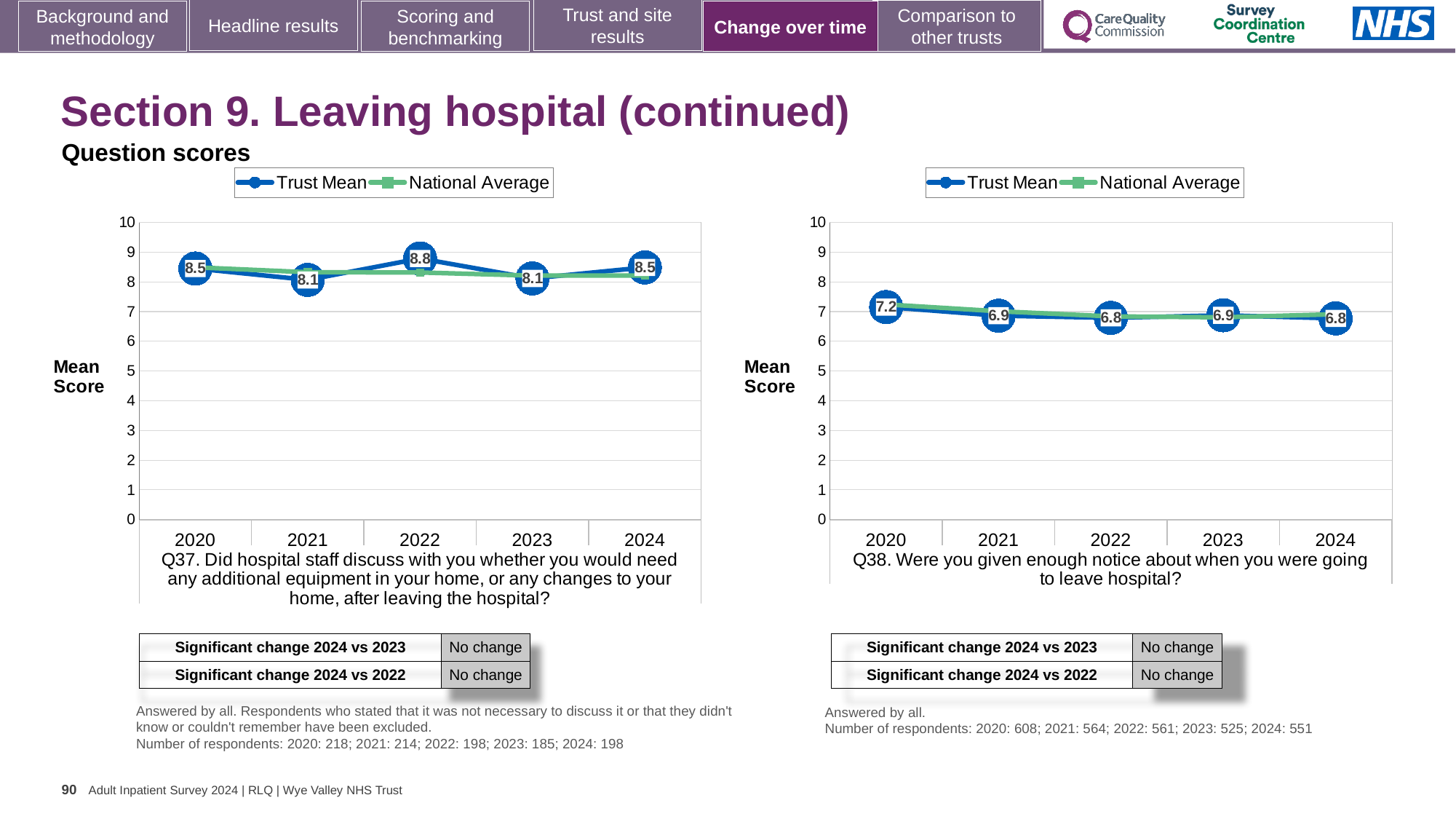
In the Q38 chart on the right, is the National Average value for 2020 greater or less than 8? less In the Q38 chart on the right, what is the Trust Mean score for 2023? 6.9 In the Q38 chart on the right, what is the Trust Mean score for 2020? 7.2 In the Q38 chart on the right, what is the difference between the Trust Mean scores for 2020 and 2024? 0.4 In the Q37 chart on the left, what is the Trust Mean score for 2024? 8.5 In the Q37 chart on the left, what is the Trust Mean score for 2022? 8.8 In the Q38 chart on the right, which year has the highest Trust Mean score? 2020 How many series does the legend of the Q37 chart on the left list? 2 In the Q38 chart on the right, does the Trust Mean score rise or fall overall from 2020 to 2024? fall In the Q37 chart on the left, what is the difference between the Trust Mean scores for 2022 and 2021? 0.7 In the Q37 chart on the left, is the Trust Mean score higher in 2022 or in 2023? 2022 In the Q37 chart on the left, which year has the highest Trust Mean score? 2022